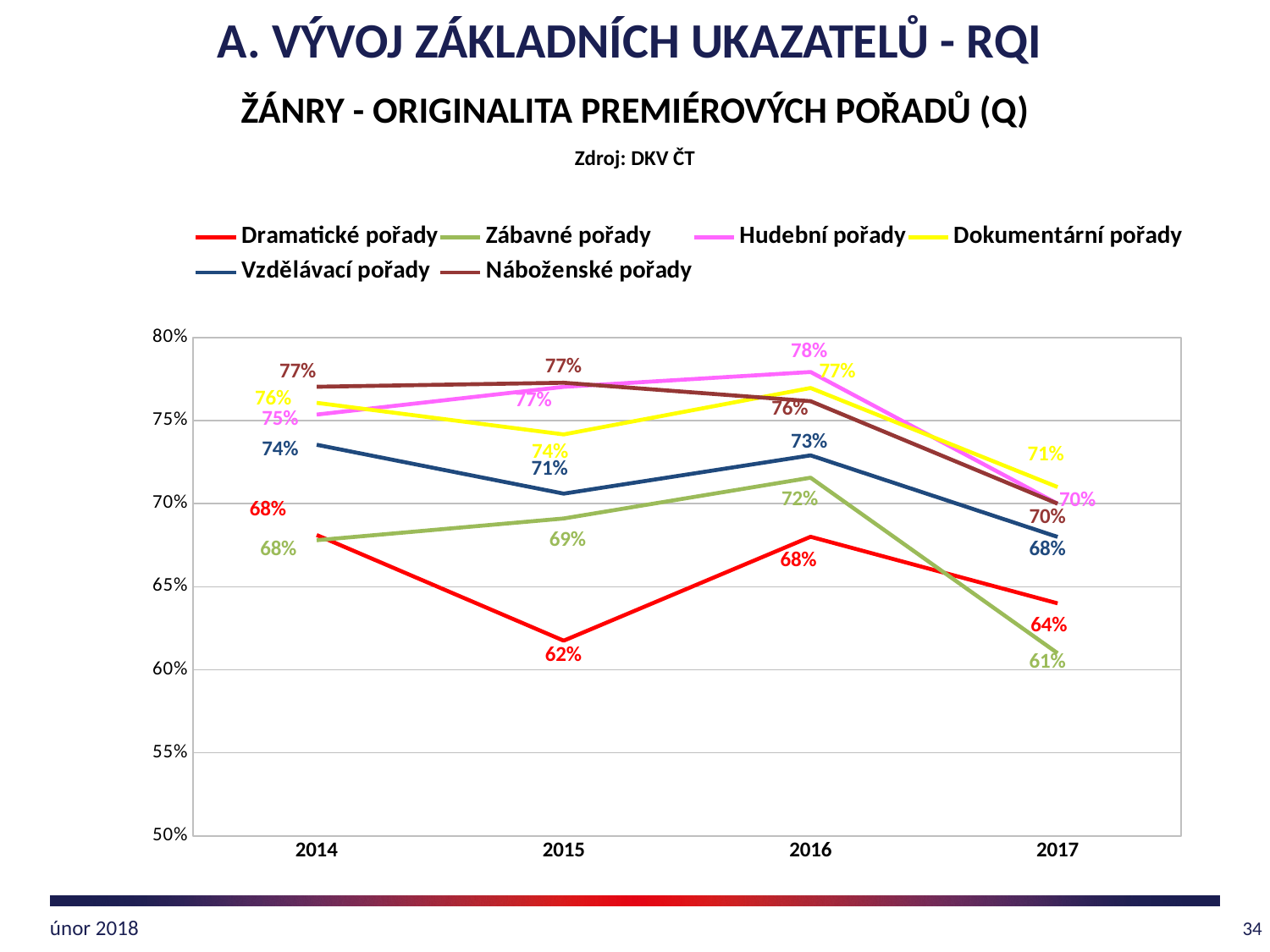
Which is larger in 2015: Dokumentární pořady or Vzdělávací pořady? Dokumentární pořady What kind of chart is shown on the slide? line chart What is the value for Vzdělávací pořady in 2014? 74% What is the value for Hudební pořady in 2016? 78% How many years are shown on the x axis? 4 What is the value for Zábavné pořady in 2017? 61% How many series does the legend list? 6 What is the difference between Náboženské pořady and Dramatické pořady in 2014? 9 percentage points What is the value for Dramatické pořady in 2015? 62% Does the value for Zábavné pořady rise or fall from 2016 to 2017? fall Which series has the highest value in 2016? Hudební pořady Which series has the lowest value in 2017? Zábavné pořady